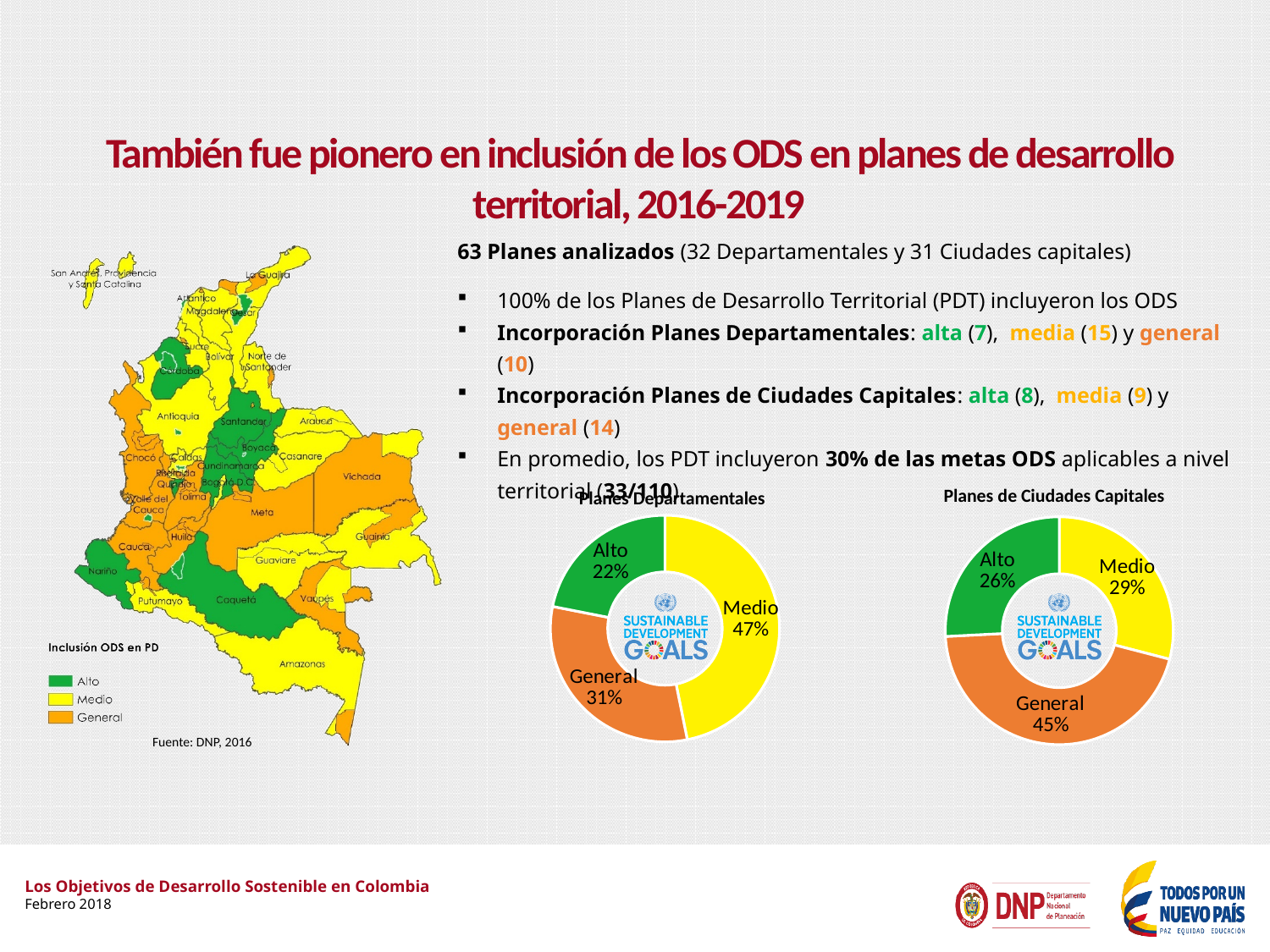
In the 'Planes Departamentales' chart, what colour is the General segment? Orange Which is larger: the Alto share in the 'Planes Departamentales' chart or the Alto share in the 'Planes de Ciudades Capitales' chart? Planes de Ciudades Capitales In the 'Planes de Ciudades Capitales' chart, what percentage is shown for Medio? 29% What type of chart is the 'Planes de Ciudades Capitales' chart? Doughnut chart In the 'Planes de Ciudades Capitales' chart, what percentage is shown for General? 45% In the 'Planes de Ciudades Capitales' chart, which category has the smallest share? Alto In the 'Planes Departamentales' chart, what percentage is shown for Alto? 22% In the 'Planes Departamentales' chart, what is the difference in percentage points between Medio and General? 16 In the 'Planes Departamentales' chart, what percentage is shown for Medio? 47% In the 'Planes Departamentales' chart, which category has the largest share? Medio In the 'Planes de Ciudades Capitales' chart, what is the difference in percentage points between General and Alto? 19 How many categories are shown in the 'Planes Departamentales' chart? 3